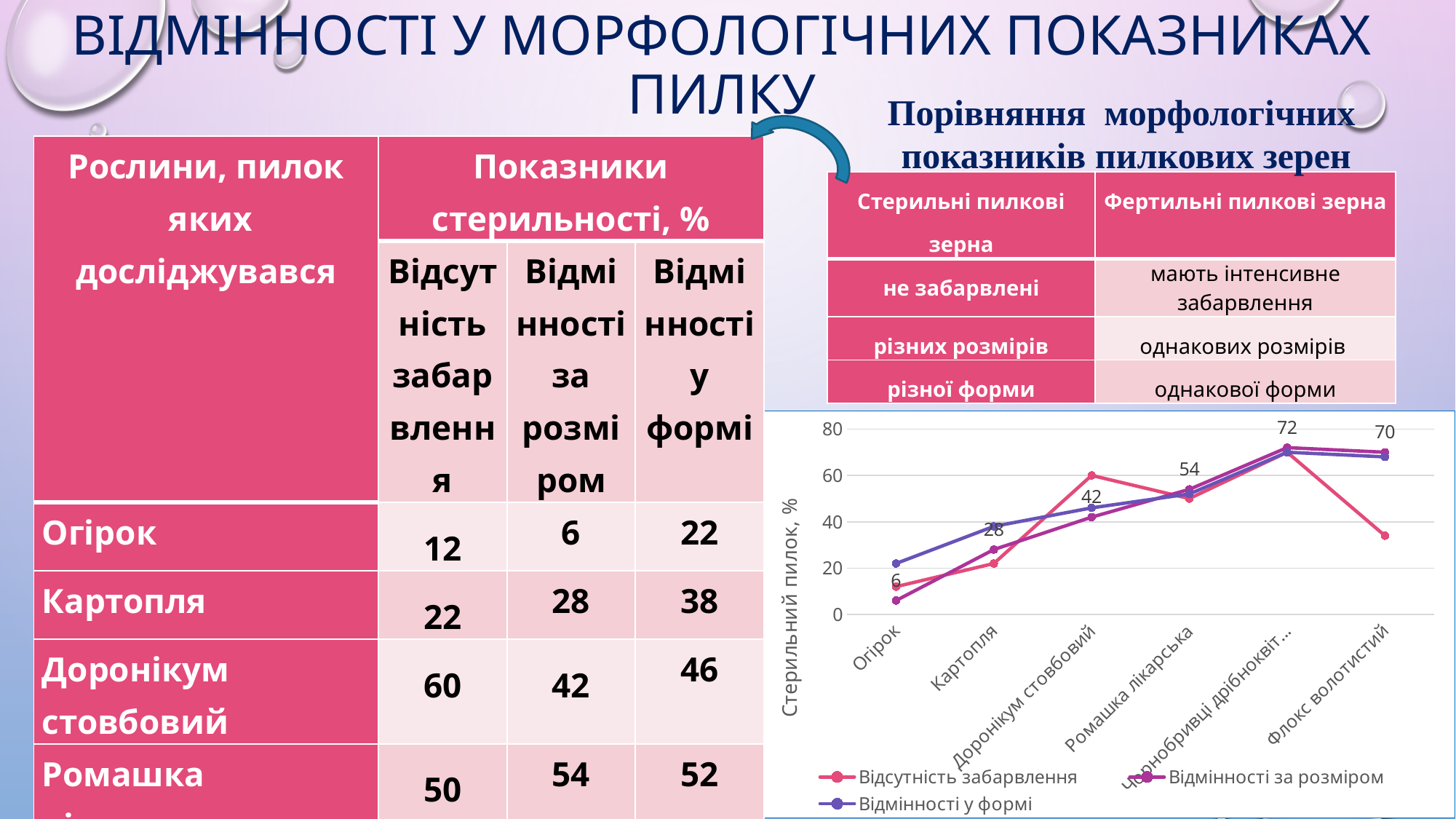
Which category has the lowest labelled value in the Відмінності за розміром series? Огірок How many plant categories are shown on the x axis of the chart? 6 What is the difference between the labelled values for Ромашка лікарська and Доронікум стовбовий in the Відмінності за розміром series? 12 What is the labelled value of the Відмінності за розміром series for Огірок? 6 What is the labelled value of the Відмінності за розміром series for Чорнобривці дрібноквіт...? 72 What is the labelled value of the Відмінності за розміром series for Картопля? 28 Is the value of the Відсутність забарвлення series for Доронікум стовбовий greater or less than 40? greater Which category has the highest labelled value in the Відмінності за розміром series? Чорнобривці дрібноквіт... What kind of chart is shown on the slide? line chart At Доронікум стовбовий, which series is higher: Відсутність забарвлення or Відмінності за розміром? Відсутність забарвлення How many series does the chart legend list? 3 What is the title of the chart's vertical axis? Стерильний пилок, %